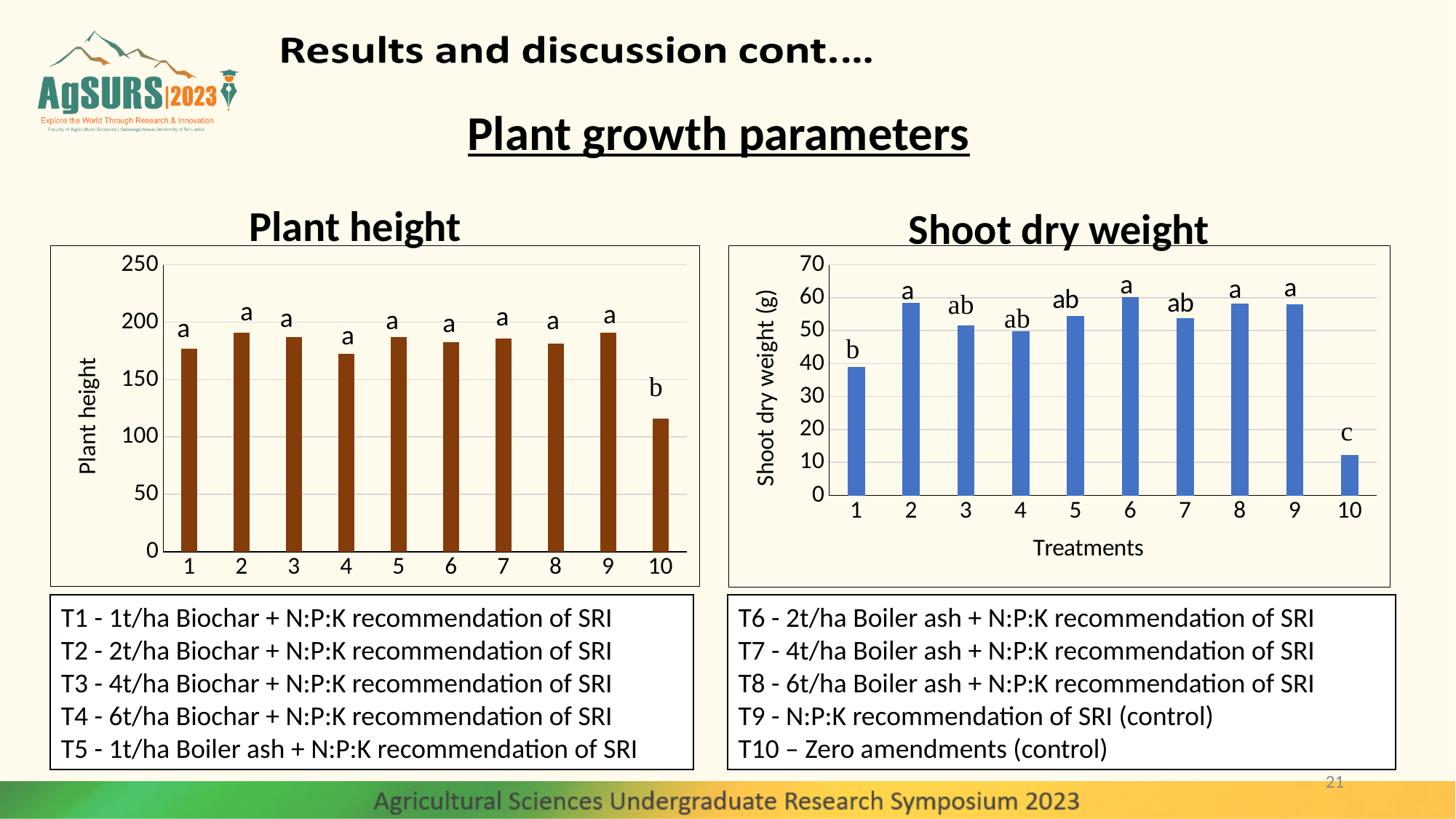
In the Plant height chart, is the value for treatment 1 greater or less than 150? greater In the Shoot dry weight chart, what is the y-axis title? Shoot dry weight (g) In the Plant height chart, is the value for treatment 4 greater or less than 200? less In the Shoot dry weight chart, is the value for treatment 6 greater or less than 50? greater What kind of chart is the Plant height chart? bar chart In the Plant height chart, which treatment has the lowest plant height? 10 How many treatments are plotted on the Shoot dry weight chart? 10 In the Shoot dry weight chart, which treatment has the lowest shoot dry weight? 10 In the Plant height chart, which is larger, the value for treatment 1 or treatment 10? treatment 1